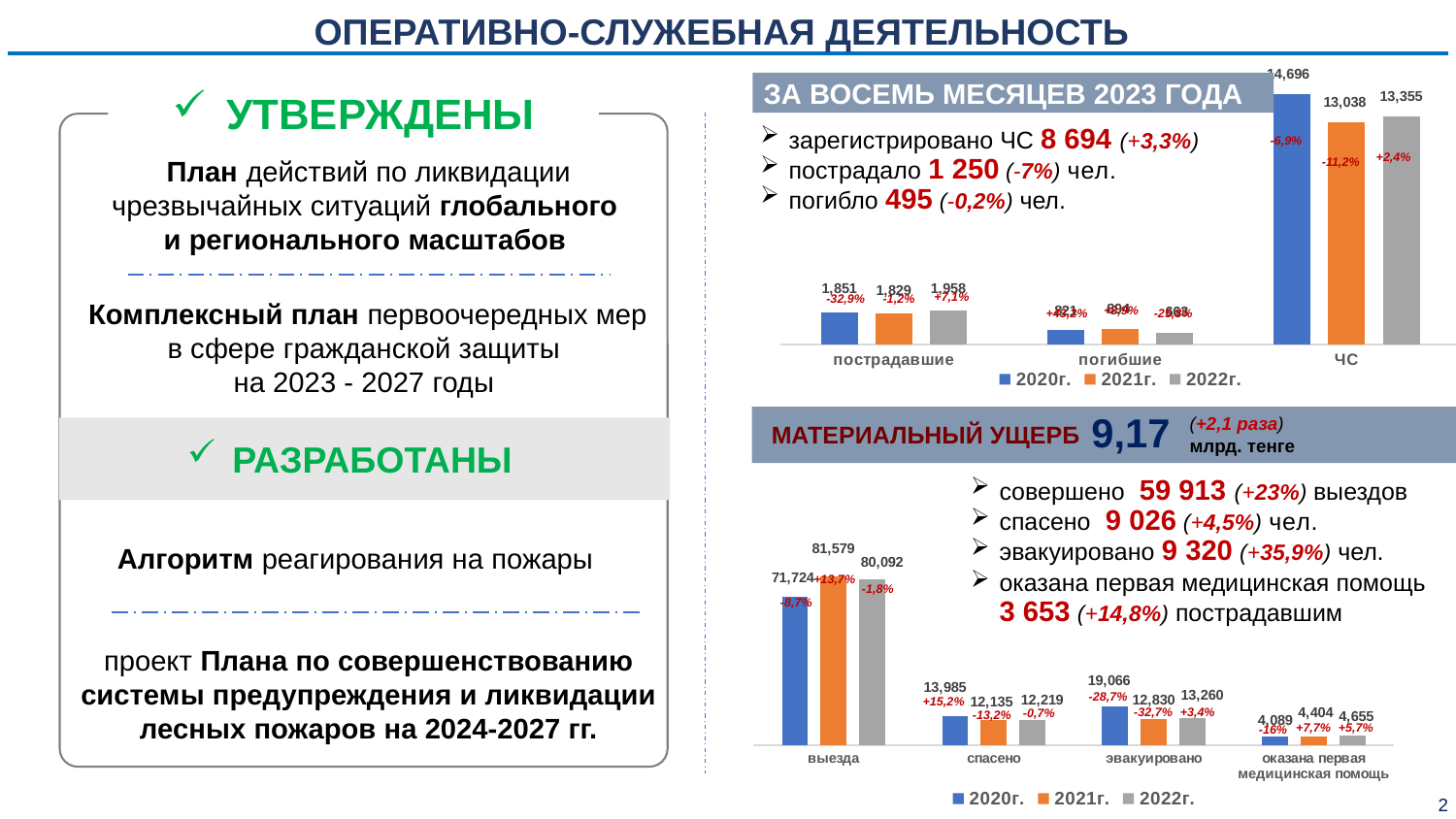
In the top chart on the right, what is the value for пострадавшие in 2022г.? 1,958 In the top chart on the right, how many series does the legend list? 3 In the top chart on the right, what kind of chart is shown? bar chart In the top chart on the right, what is the value for ЧС in 2020г.? 14,696 In the bottom chart on the right, what is the difference between the 2022г. and 2021г. values for оказана первая медицинская помощь? 251 In the bottom chart on the right, which year has the lowest value for оказана первая медицинская помощь? 2020г. In the top chart on the right, which year has the highest value for ЧС? 2020г. In the bottom chart on the right, what is the value for эвакуировано in 2020г.? 19,066 In the bottom chart on the right, how many categories are shown on the x axis? 4 In the top chart on the right, what is the difference between the 2020г. and 2021г. values for ЧС? 1,658 In the bottom chart on the right, what is the value for выезда in 2021г.? 81,579 In the bottom chart on the right, which is larger: спасено in 2020г. or эвакуировано in 2020г.? эвакуировано in 2020г.